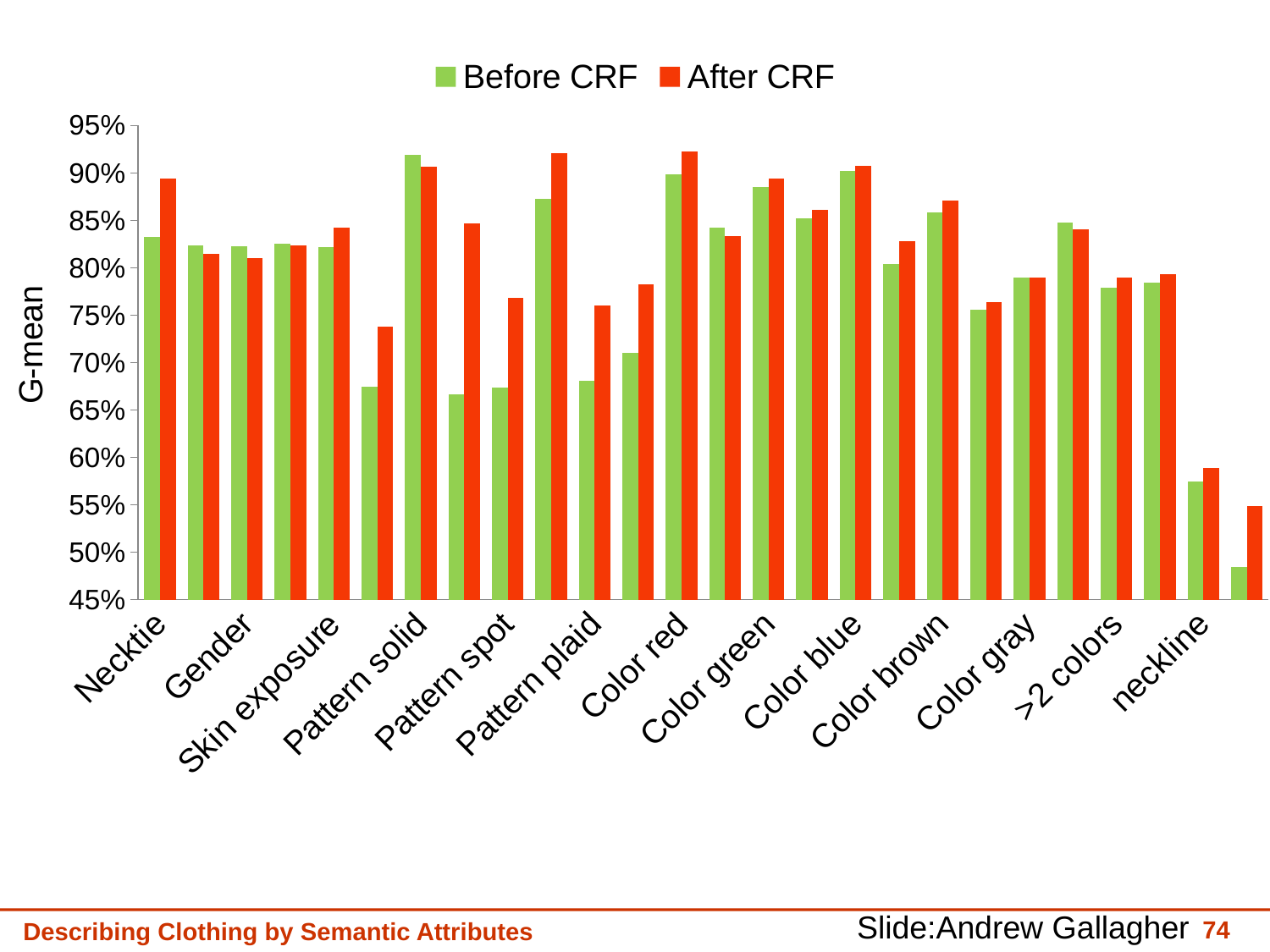
What kind of chart is shown on the slide? bar chart For Pattern spot, which is larger: the Before CRF value or the After CRF value? After CRF How many series does the legend list? 2 Is the Before CRF value for neckline greater or less than 60%? less What are the two series named in the legend? Before CRF, After CRF Is the Before CRF value for Necktie greater or less than 80%? greater What is the label on the vertical axis? G-mean For Necktie, which is larger: the Before CRF value or the After CRF value? After CRF Is the After CRF value for Color red greater or less than 90%? greater For Pattern plaid, which is larger: the Before CRF value or the After CRF value? After CRF